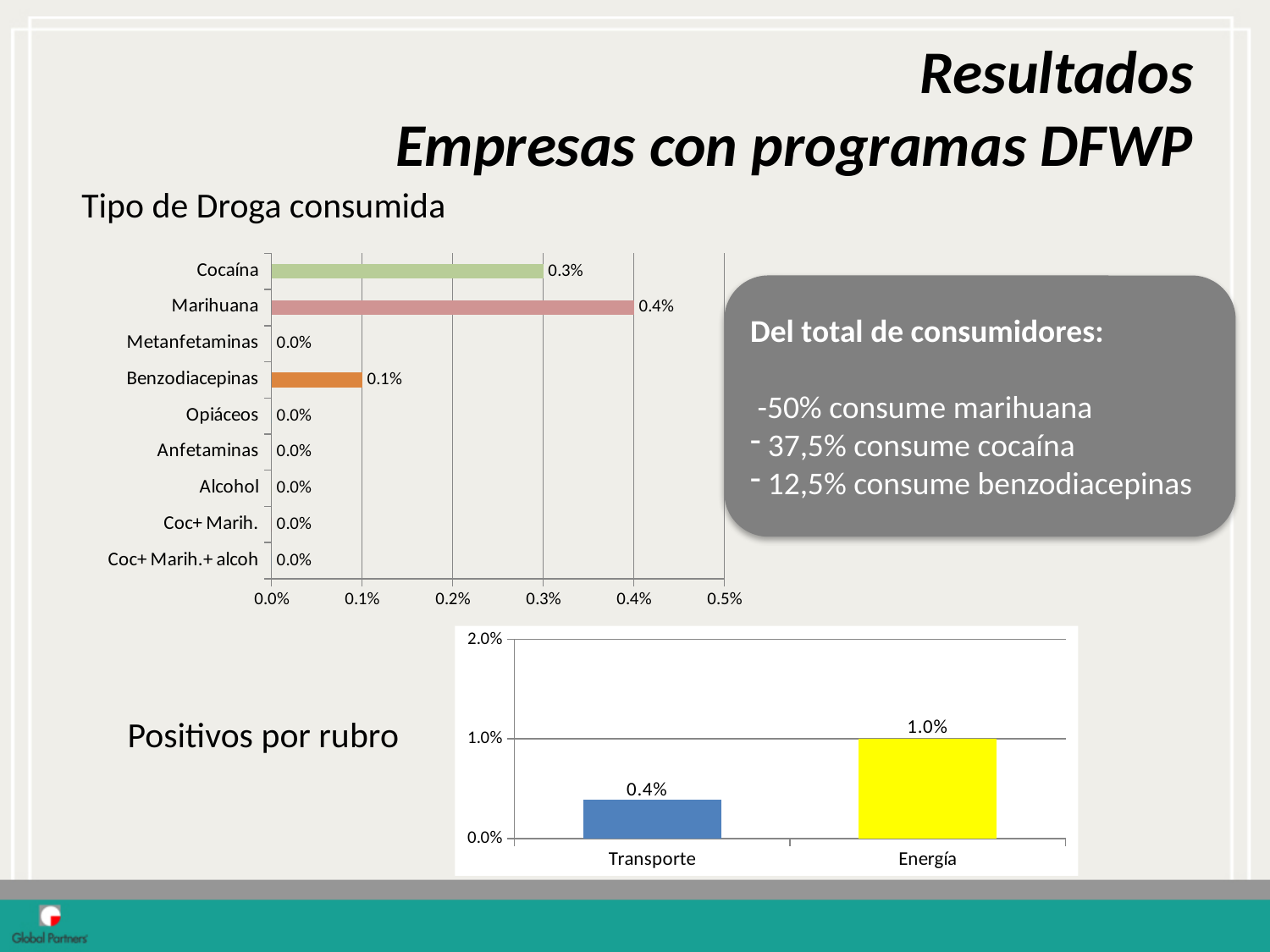
What kind of chart is the 'Tipo de Droga consumida' chart? Bar chart In the 'Tipo de Droga consumida' chart, what is the difference between the values for Marihuana and Cocaína? 0.1% In the 'Tipo de Droga consumida' chart, what is the value for Benzodiacepinas? 0.1% In the 'Positivos por rubro' chart, what is the difference between the values for Energía and Transporte? 0.6% In the 'Tipo de Droga consumida' chart, what is the value for Marihuana? 0.4% In the 'Positivos por rubro' chart, what is the value for Transporte? 0.4% In the 'Tipo de Droga consumida' chart, which is larger, the value for Cocaína or the value for Benzodiacepinas? Cocaína In the 'Tipo de Droga consumida' chart, what is the value for Cocaína? 0.3% In the 'Positivos por rubro' chart, what is the value for Energía? 1.0% In the 'Positivos por rubro' chart, what colour is the bar for Energía? Yellow In the 'Tipo de Droga consumida' chart, which category has the highest value? Marihuana How many categories are shown in the 'Tipo de Droga consumida' chart? 9